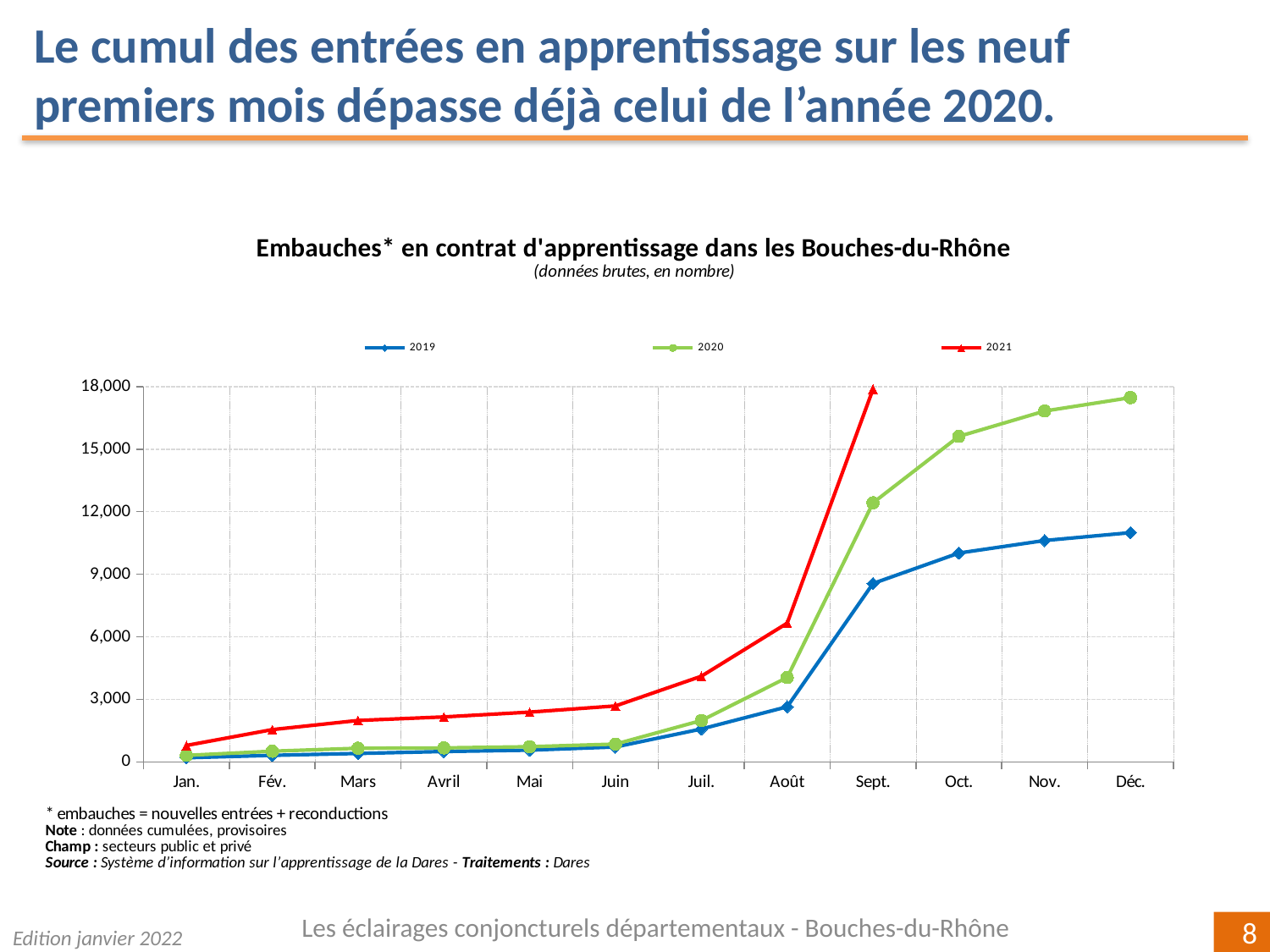
Up to which month does the 2021 series extend? Sept. In Mars, which series has the larger value, 2021 or 2019? 2021 Is the value for 2021 in Sept. greater or less than 15,000? greater Is the value for 2021 in Août greater or less than 9,000? less What kind of chart is shown on the slide? line chart Is the value for 2019 in Déc. greater or less than 12,000? less How many months are shown on the x axis? 12 How many series does the legend list? 3 Do the values for the 2020 series rise or fall from Jan. to Déc.? rise Which series has the highest value in Sept.? 2021 Which series has the lowest value in Déc.? 2019